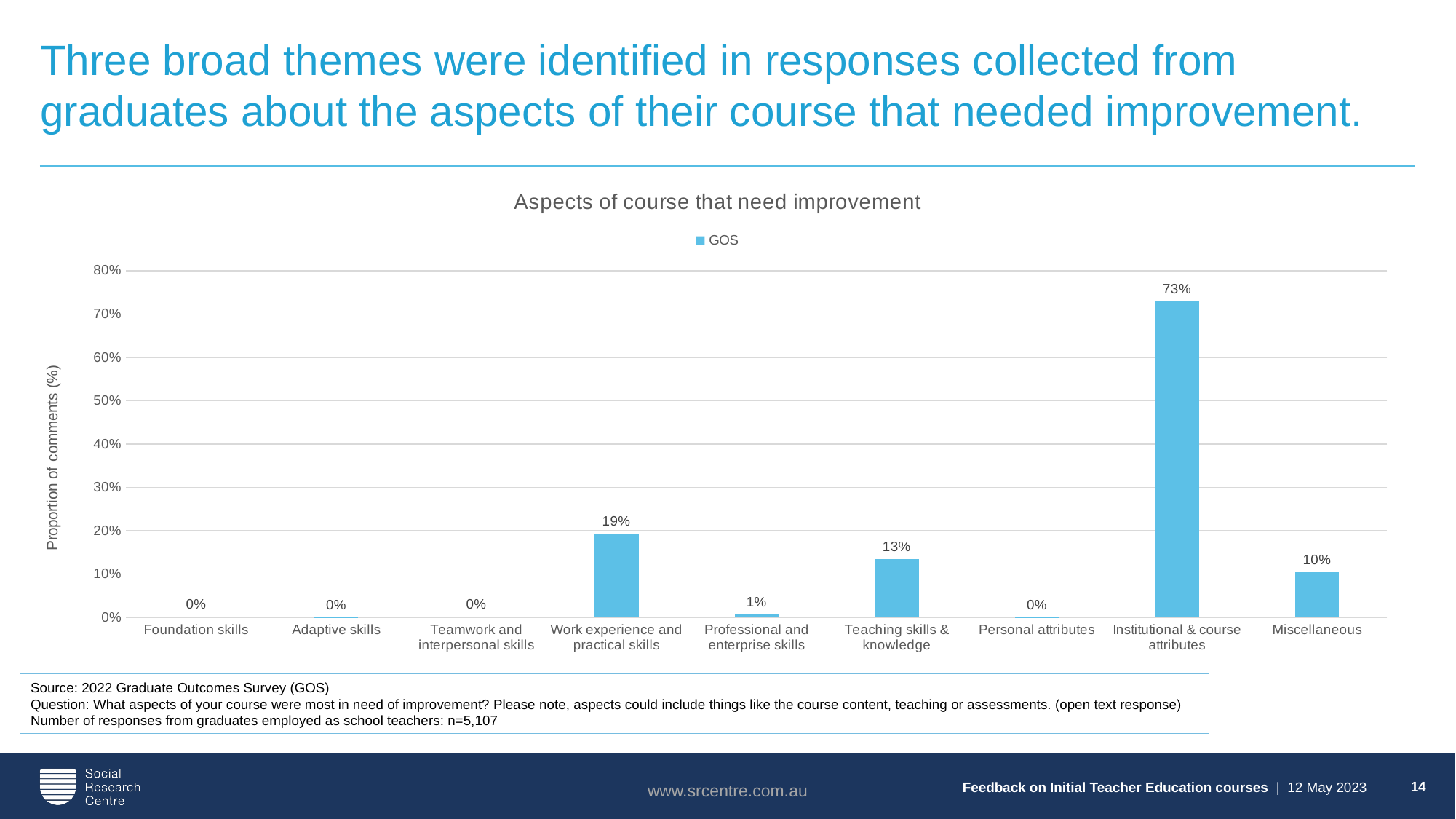
What kind of chart is shown? bar chart Is the value for Institutional & course attributes greater or less than 70%? greater What is the title of the chart? Aspects of course that need improvement What is the value for Professional and enterprise skills? 1% What is the value for Teaching skills & knowledge? 13% What is the difference between the values for Institutional & course attributes and Work experience and practical skills? 54% What is the value for Work experience and practical skills? 19% Which is larger, the value for Teaching skills & knowledge or the value for Miscellaneous? Teaching skills & knowledge What is the value for Institutional & course attributes? 73% What is the value for Miscellaneous? 10% How many categories are shown on the x axis? 9 Which category has the highest value? Institutional & course attributes